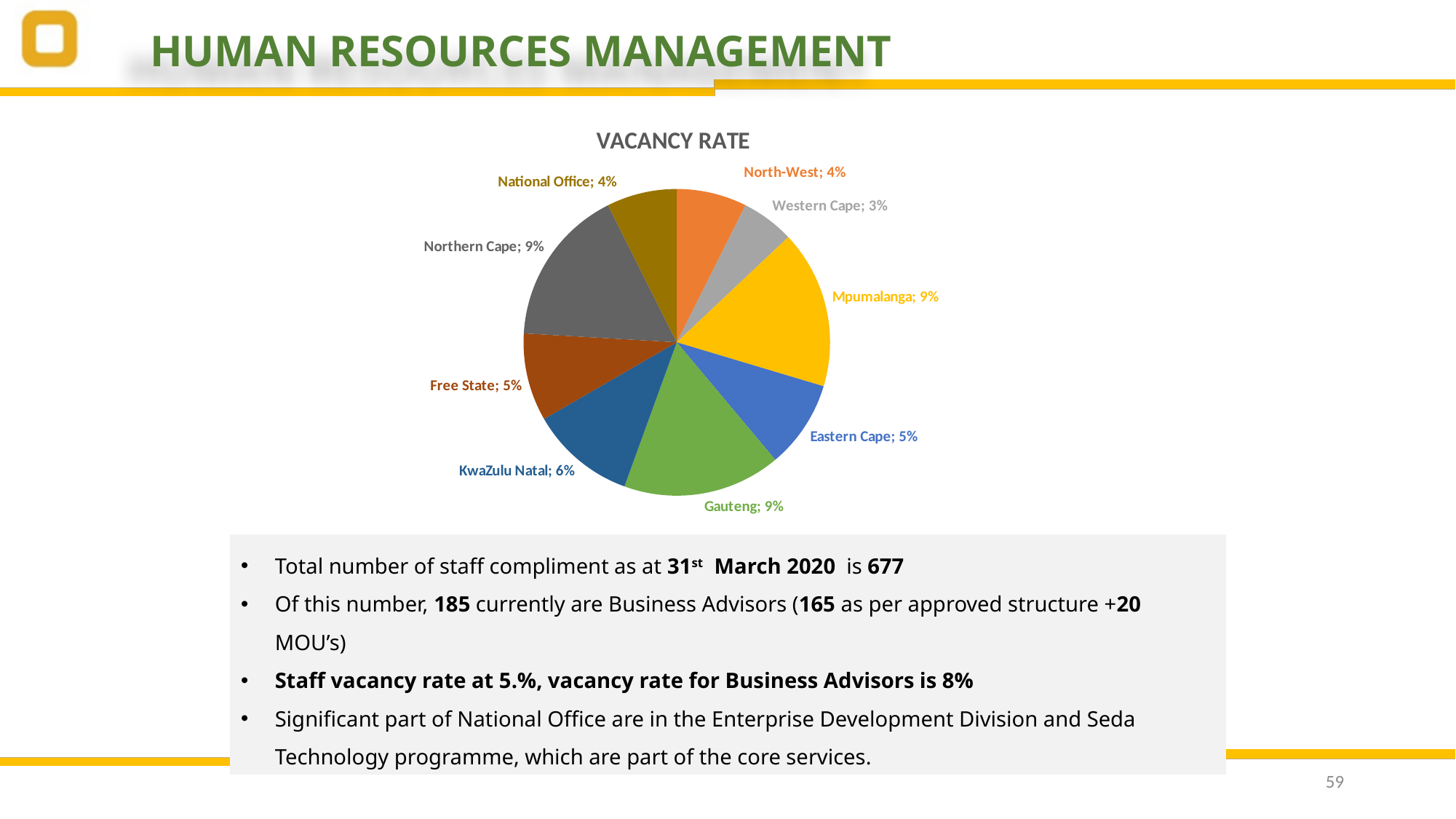
Which category has the lowest vacancy rate in the pie chart? Western Cape How many slices does the pie chart have? 9 Which categories share the highest vacancy rate in the pie chart? Mpumalanga, Gauteng and Northern Cape What is the difference between the vacancy rates of Northern Cape and Free State? 4 percentage points What is the vacancy rate shown for KwaZulu Natal? 6% What is the vacancy rate shown for National Office? 4% Which has a higher vacancy rate, Gauteng or Eastern Cape? Gauteng What is the title of the chart? VACANCY RATE What type of chart is shown on the slide? pie chart What is the vacancy rate shown for Western Cape? 3% What is the vacancy rate shown for Mpumalanga? 9% What colour is the Gauteng slice in the pie chart? green